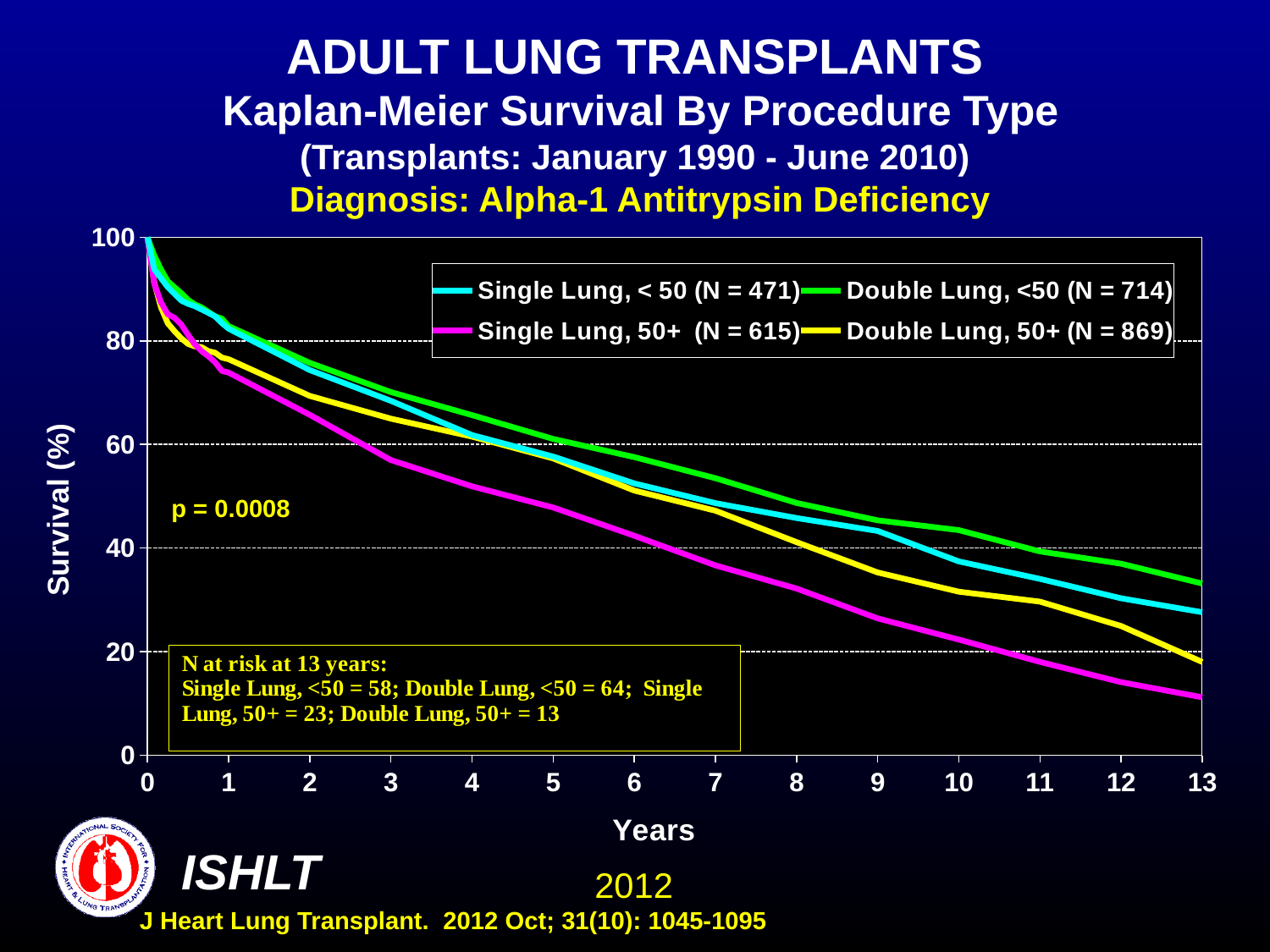
Which series has the highest survival at 13 years? Double Lung, <50 What p-value is shown on the chart? p = 0.0008 Is the survival for Double Lung, <50 at 1 year greater or less than 80? greater Is the survival for Single Lung, < 50 at 13 years greater or less than 40? less How many series does the legend list? 4 Which series has the lowest survival at 13 years? Single Lung, 50+ Is the survival for Single Lung, 50+ at 5 years greater or less than 60? less Do the survival curves rise or fall as years increase? fall At 10 years, which series has higher survival: Double Lung, <50 or Single Lung, 50+? Double Lung, <50 What kind of chart is shown on the slide? line chart